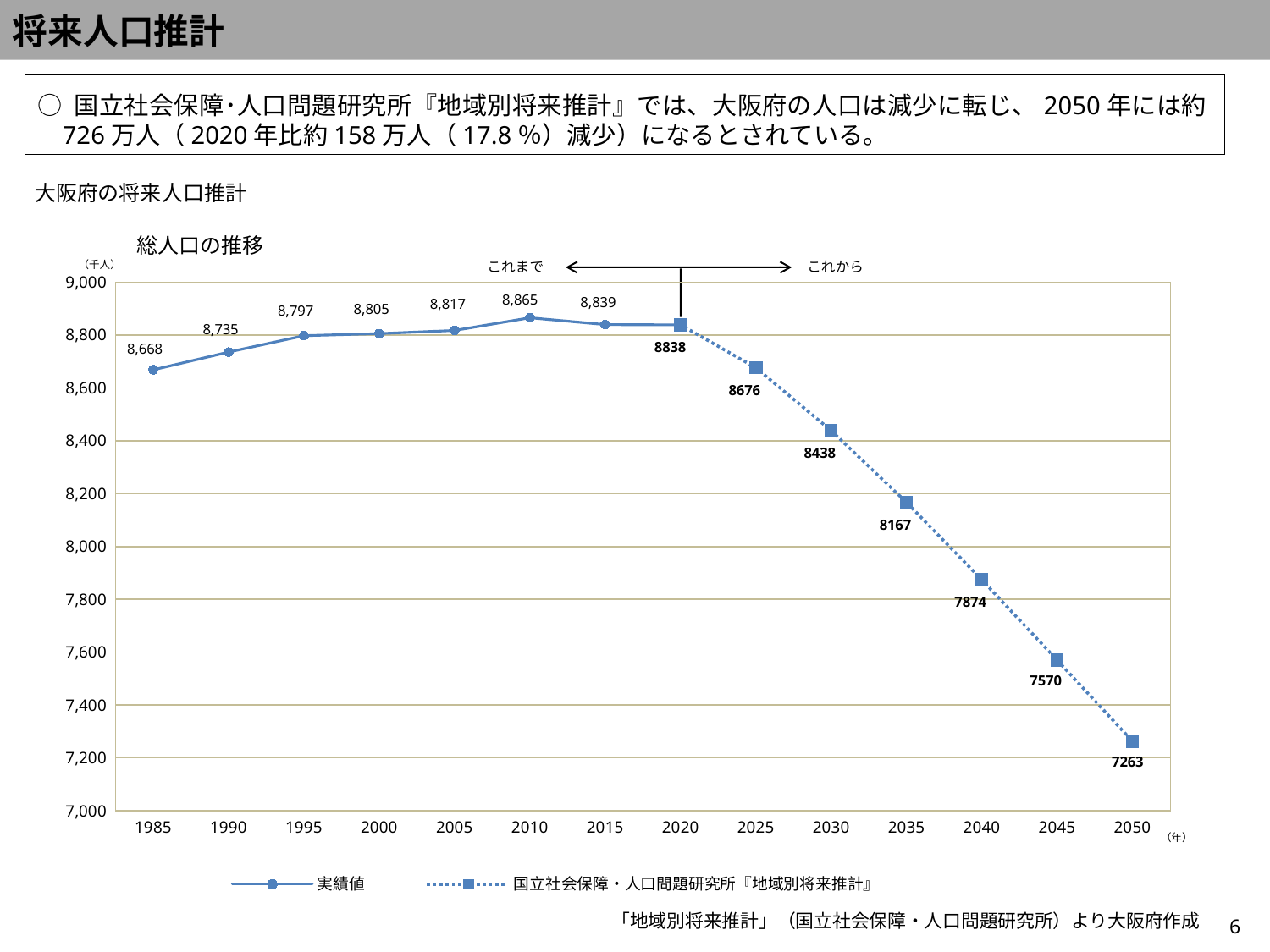
Which year has the lowest value on the chart? 2050 Which is larger, the value for 2000 or the value for 2005? 2005 How many series does the legend list? 2 What is the population value shown for 1985? 8,668 Which year has the highest value on the chart? 2010 What is the projected population value shown for 2050? 7263 Is the value for 2040 greater or less than 8,000? less What is the difference between the 2020 value (8838) and the 2050 value (7263)? 1575 What is the value shown for 2010? 8,865 What is the projected value shown for 2035? 8167 How many years are plotted along the x axis? 14 What kind of chart is shown on the slide? line chart